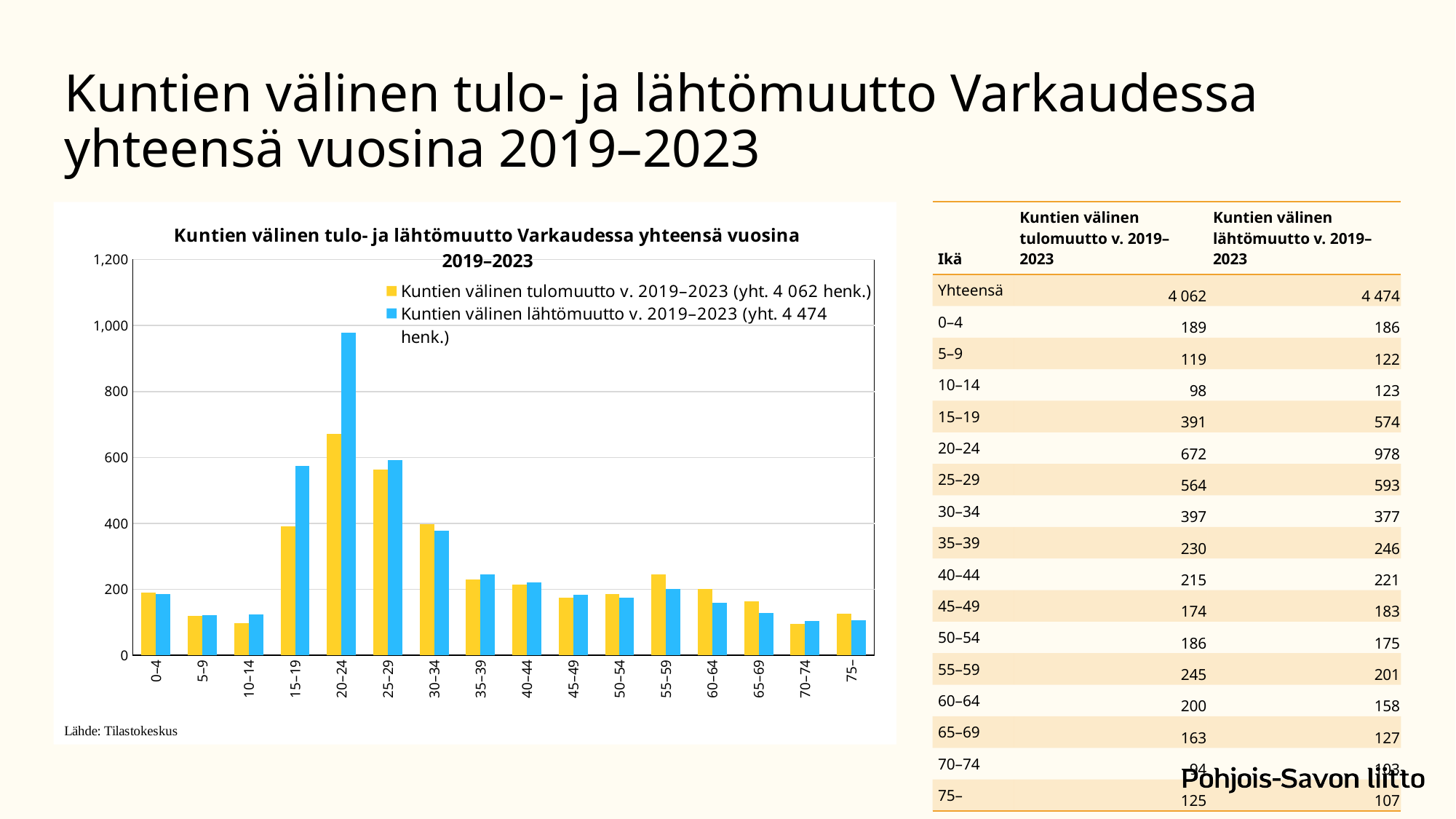
How many series does the chart legend list? 2 For the 55–59 age group, which is larger: tulomuutto or lähtömuutto? tulomuutto How many age groups are shown on the x axis of the chart? 16 What is the total Kuntien välinen tulomuutto v. 2019–2023 given in the legend? 4 062 henk. Which age group has the highest value for Kuntien välinen lähtömuutto v. 2019–2023? 20–24 What is the value of Kuntien välinen tulomuutto v. 2019–2023 for the 15–19 age group? 391 Which colour represents Kuntien välinen lähtömuutto v. 2019–2023 in the chart? blue Is the value of Kuntien välinen lähtömuutto v. 2019–2023 for the 15–19 age group greater or less than 400? greater What is the difference between lähtömuutto and tulomuutto for the 20–24 age group? 306 Which age group has the highest value for Kuntien välinen tulomuutto v. 2019–2023? 20–24 What is the value of Kuntien välinen lähtömuutto v. 2019–2023 for the 20–24 age group? 978 What kind of chart is shown on the slide? bar chart